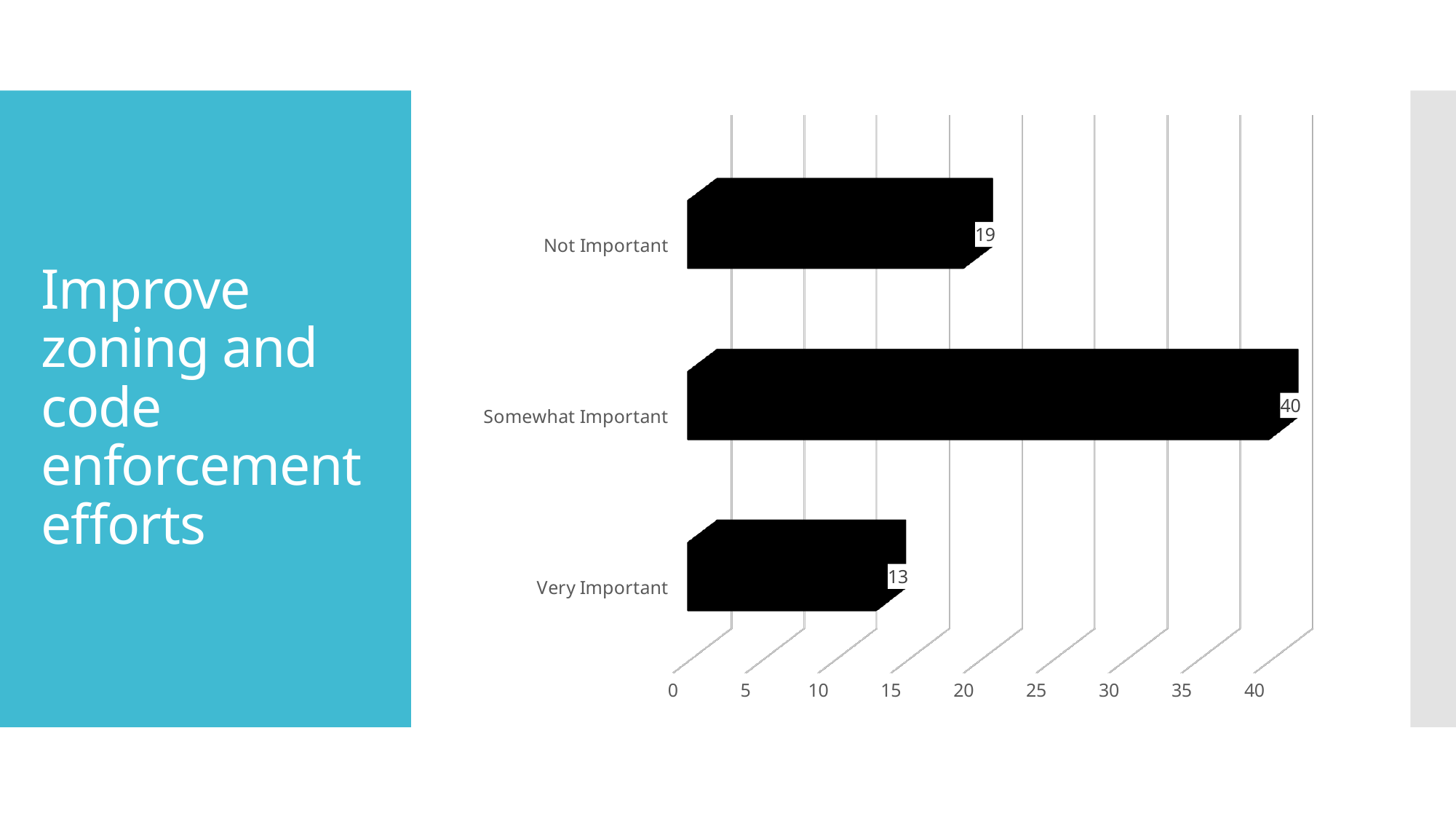
What is the difference between the values for Somewhat Important and Very Important? 27 Which is larger, the value for Not Important or the value for Very Important? Not Important Is the value for Not Important greater or less than 20? less Which category has the lowest value? Very Important Which category has the highest value? Somewhat Important How many categories are shown in the chart? 3 What is the value for Somewhat Important? 40 What is the title text on the slide next to the chart? Improve zoning and code enforcement efforts What is the value for Very Important? 13 What is the value for Not Important? 19 What is the difference between the values for Not Important and Very Important? 6 What kind of chart is shown on the slide? bar chart